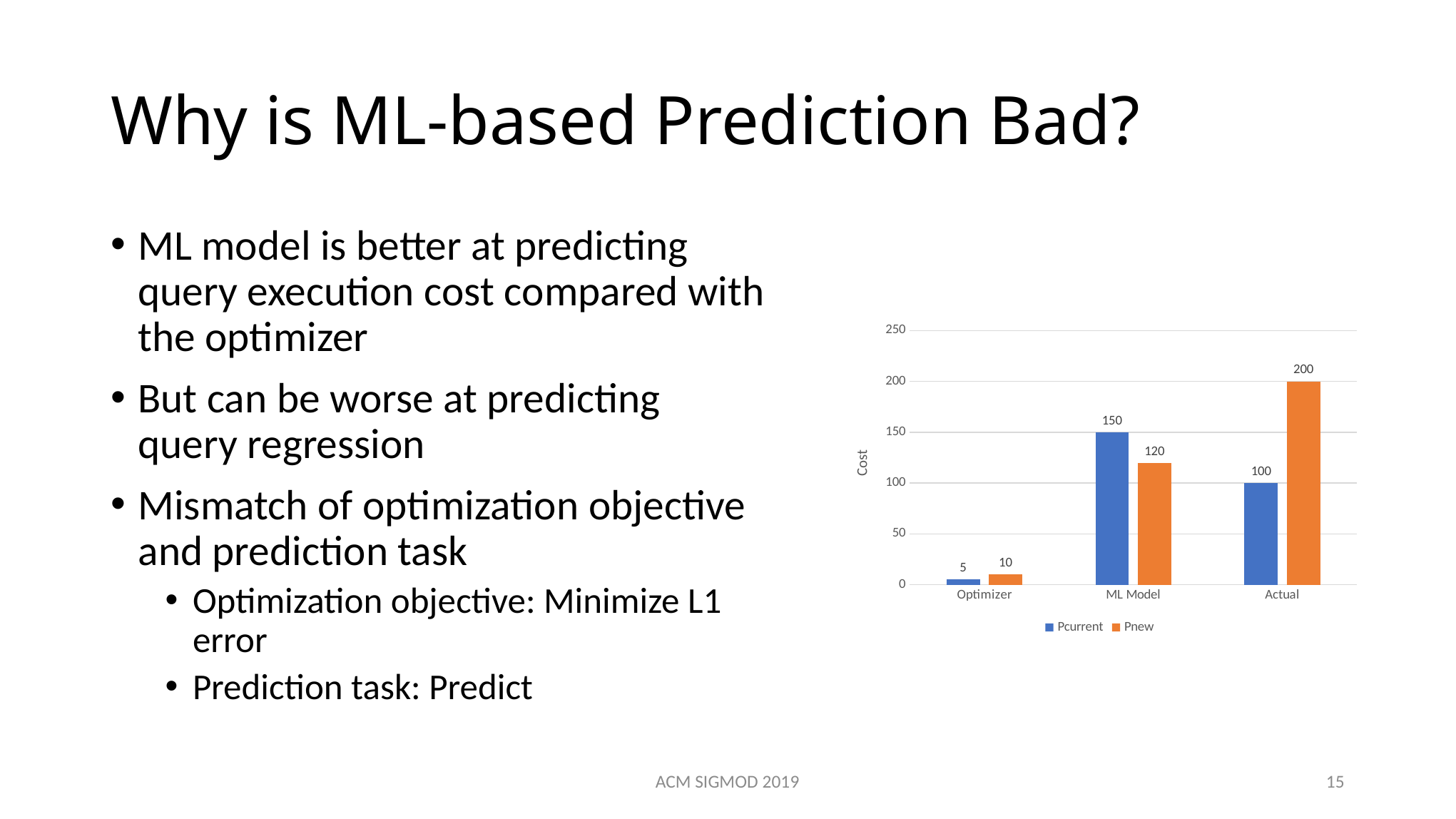
Which category has the highest Pnew value? Actual What is the Pnew value for Optimizer? 10 What is the Pcurrent value for Actual? 100 For Actual, which series has the larger value, Pcurrent or Pnew? Pnew What is the Pcurrent value for ML Model? 150 Which category has the lowest Pcurrent value? Optimizer What is the label of the vertical axis? Cost What is the difference between the Pcurrent and Pnew values for ML Model? 30 How many series does the legend list? 2 How many categories are shown on the x axis? 3 What is the Pnew value for Actual? 200 What kind of chart is shown on the slide? Bar chart